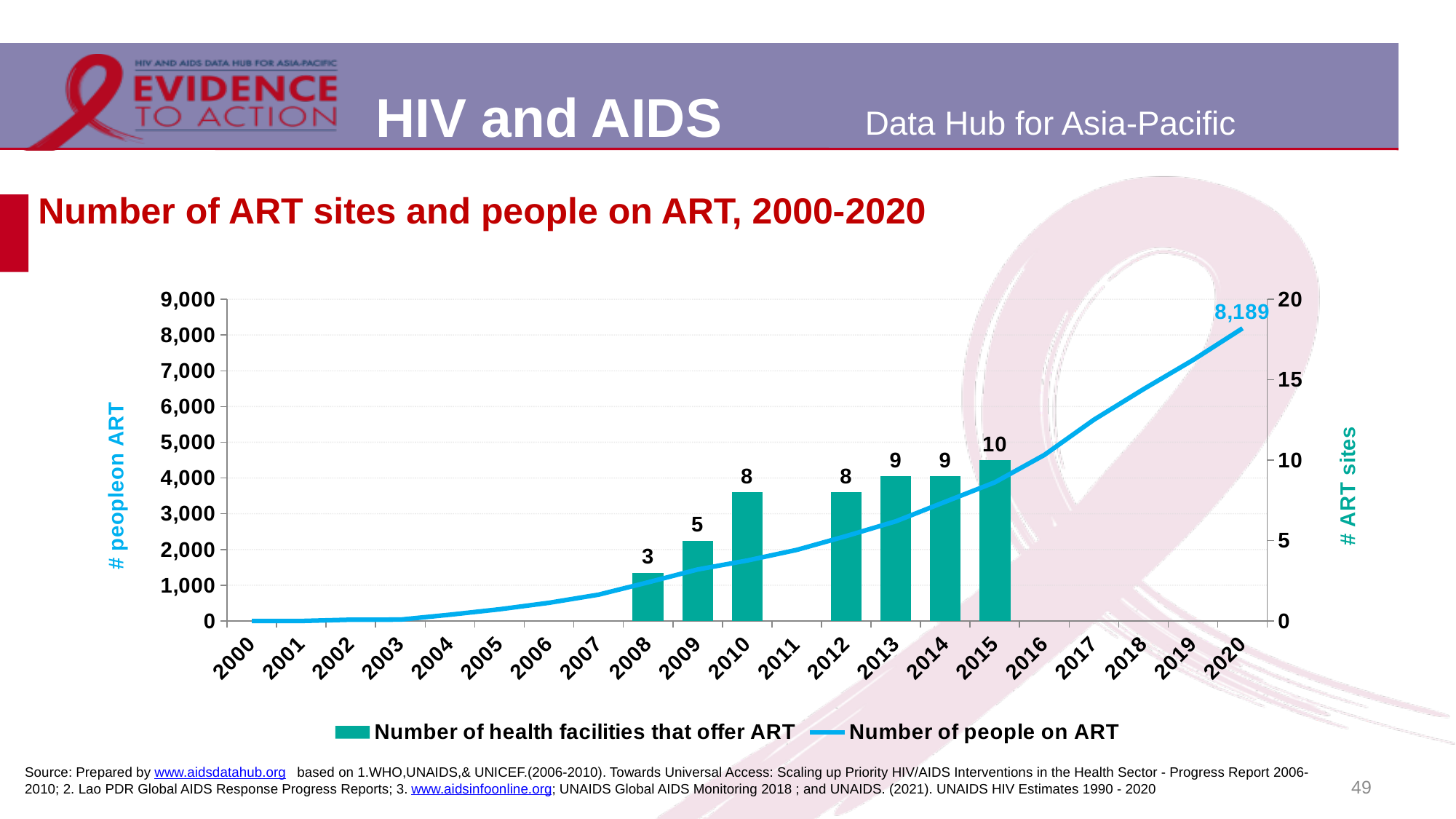
Is the number of people on ART in 2016 greater or less than 4,000? greater What is the number of health facilities that offer ART in 2008? 3 What is the number of people on ART in 2020? 8,189 Does the number of people on ART rise or fall from 2000 to 2020? rise What is the difference between the number of health facilities that offer ART in 2015 and in 2008? 7 Which is larger, the number of health facilities that offer ART in 2010 or in 2009? 2010 How many years have a bar for the number of health facilities that offer ART? 7 What is the number of health facilities that offer ART in 2015? 10 How many series does the legend list? 2 Which year has the lowest number of health facilities that offer ART among the years with bars? 2008 Is the number of people on ART in 2010 greater or less than 2,000? less Which year has the highest number of health facilities that offer ART? 2015